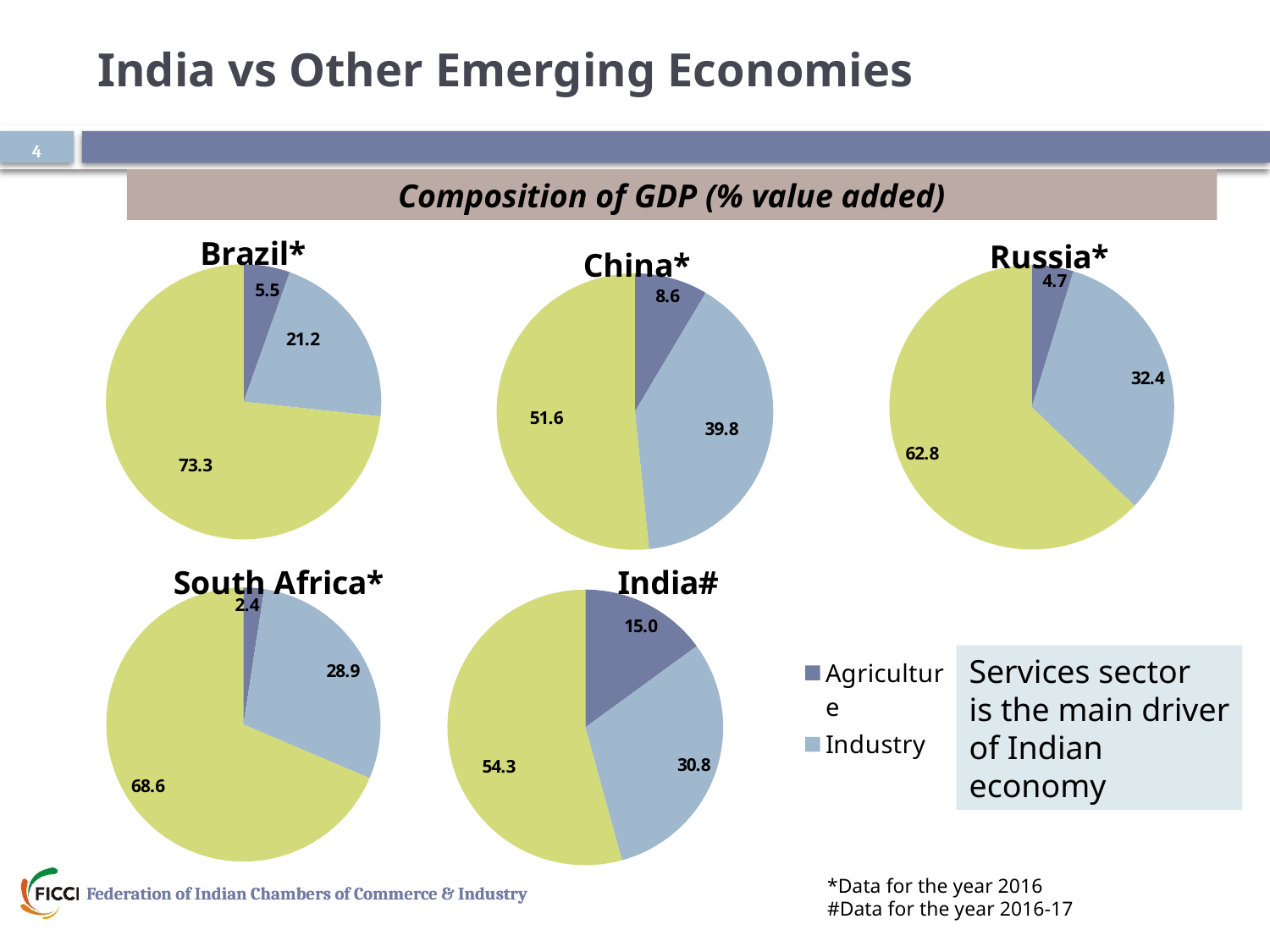
In the Russia* pie chart, what is the value of the largest slice? 62.8 What type of chart is used for each country on the slide? Pie chart In the India# pie chart, what is the difference between the Industry value and the Agriculture value? 15.8 Across the five pie charts, which country has the lowest Agriculture value? South Africa* In the India# pie chart, what is the value of the Agriculture slice? 15.0 In the China* pie chart, what is the value of the Industry slice? 39.8 How many pie charts are shown on the slide? 5 In the Brazil* pie chart, what is the value of the Agriculture slice? 5.5 Across the five pie charts, which country has the highest Industry value? China* Is the Industry value larger in the China* pie chart or the Russia* pie chart? China* Across the five pie charts, which country has the highest Agriculture value? India#